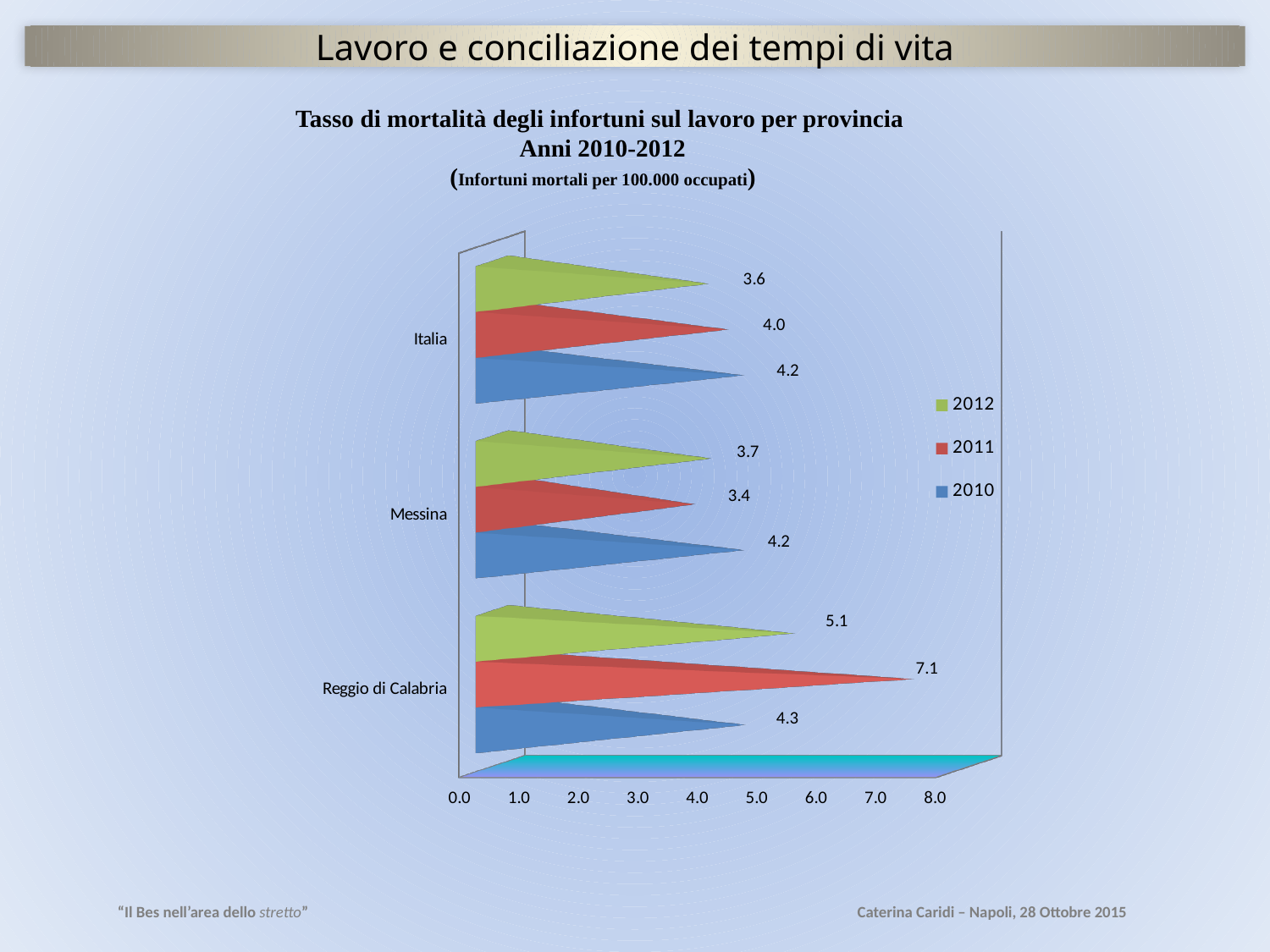
Which year does the red series represent in the legend? 2011 What is the value for Italia in 2010? 4.2 What is the value for Reggio di Calabria in 2011? 7.1 How many categories are shown on the chart? 3 Which is larger for Messina: the 2010 value or the 2011 value? 2010 What is the value for Messina in 2012? 3.7 Which province has the highest value in 2011? Reggio di Calabria How many series does the legend list? 3 What kind of chart is shown on the slide? bar chart Is the value for Reggio di Calabria in 2011 greater or less than 6.0? greater What is the difference between the 2011 and 2012 values for Reggio di Calabria? 2.0 Which category has the lowest value in 2012? Italia